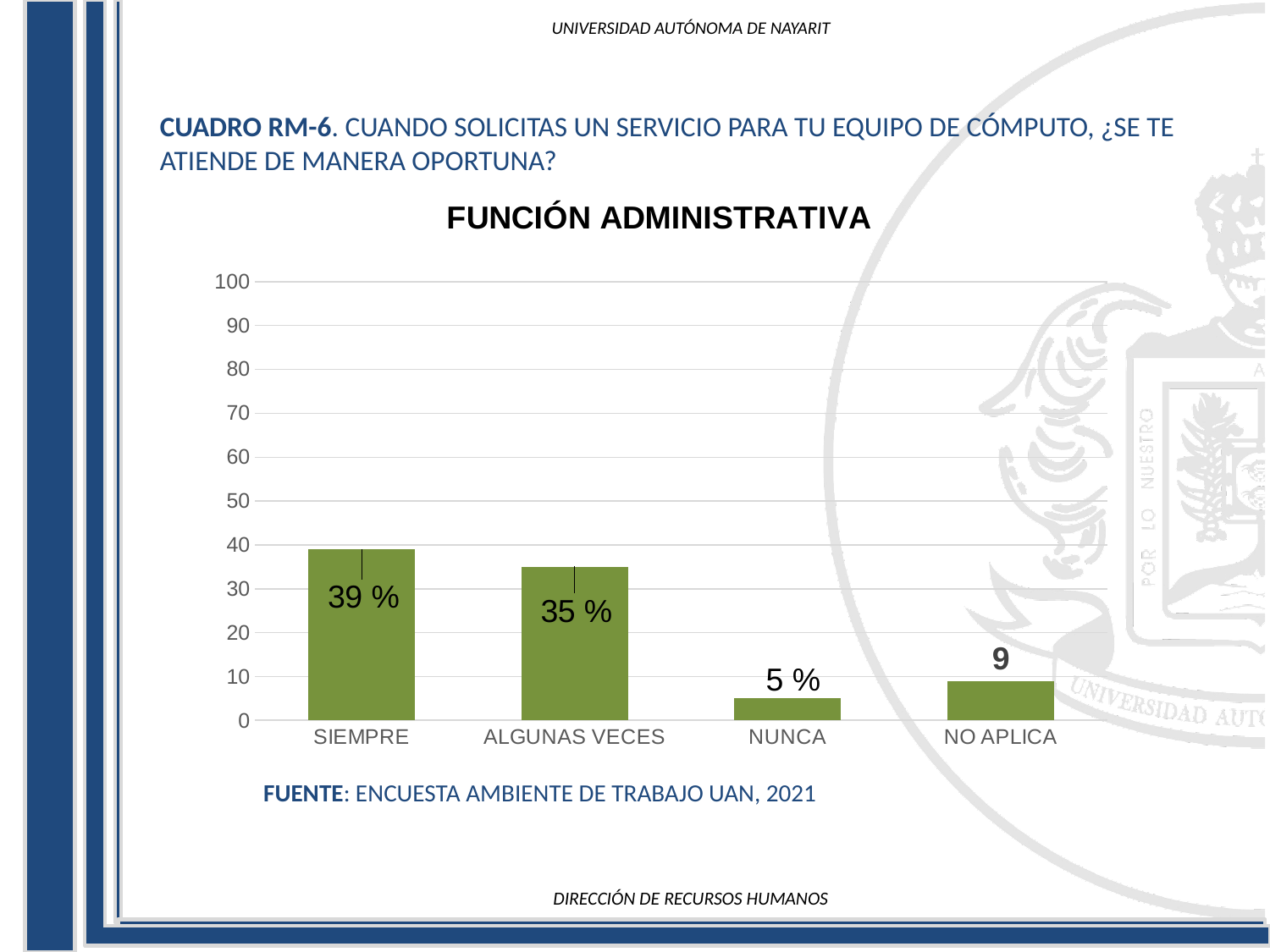
What is the data label shown for NO APLICA? 9 Is the value for SIEMPRE greater or less than 30? greater Which is larger, the value for ALGUNAS VECES or the value for NUNCA? ALGUNAS VECES How many categories are shown on the x axis? 4 Which category has the highest value? SIEMPRE What is the value for SIEMPRE? 39 % What is the value for NUNCA? 5 % What is the difference between the values for SIEMPRE and ALGUNAS VECES? 4 % Which category has the lowest value? NUNCA What kind of chart is shown? bar chart What is the value for ALGUNAS VECES? 35 % What is the title of the chart? FUNCIÓN ADMINISTRATIVA